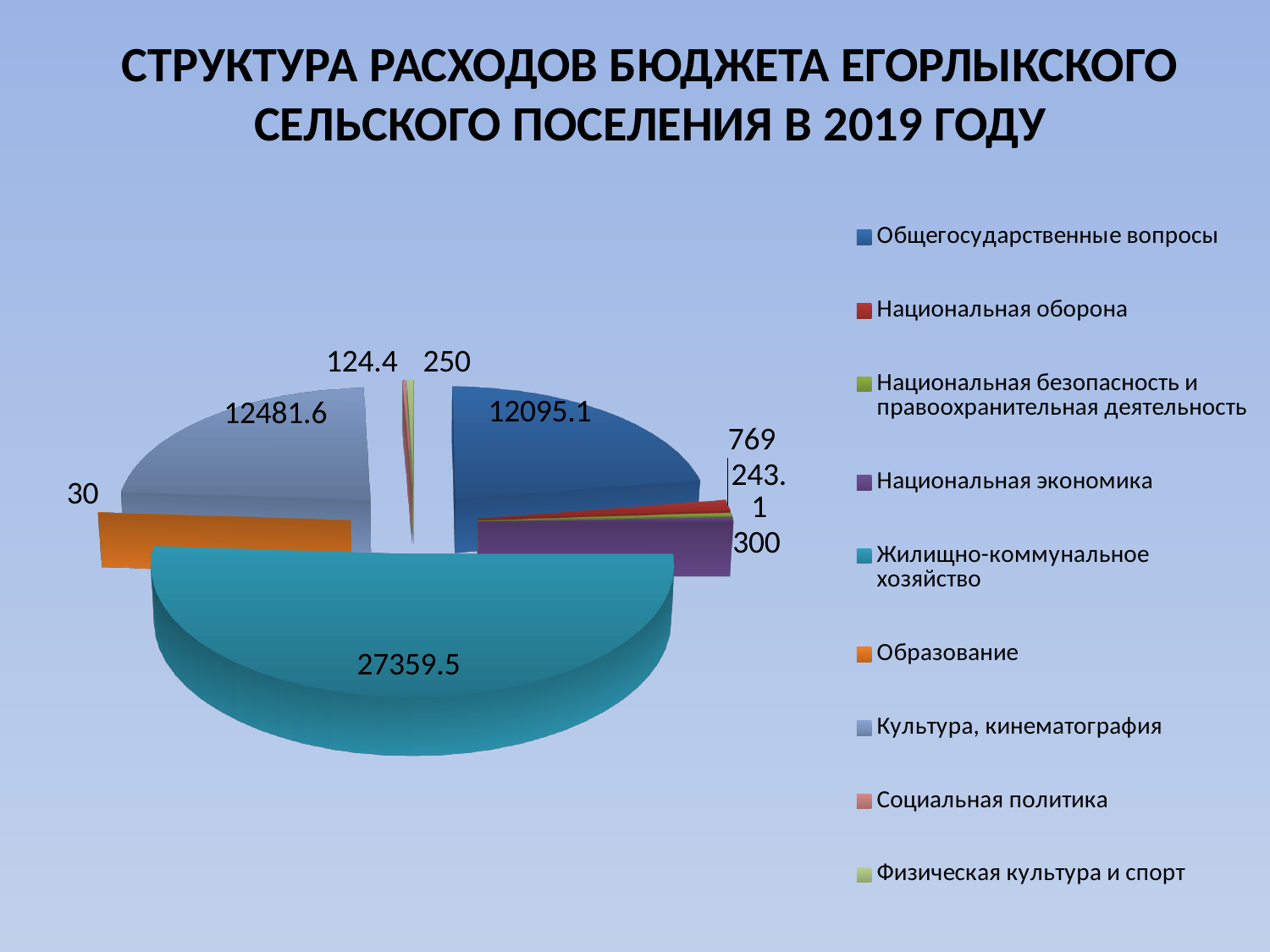
What is the value for Жилищно-коммунальное хозяйство? 27359.5 Which category has the largest slice of the pie? Жилищно-коммунальное хозяйство What is the difference between the values for Культура, кинематография and Общегосударственные вопросы? 386.5 Which is larger, the value for Национальная экономика or the value for Национальная оборона? Национальная оборона What is the value for Культура, кинематография? 12481.6 What is the value for Общегосударственные вопросы? 12095.1 How many categories does the legend list? 9 What is the value for Физическая культура и спорт? 250 What is the value for Образование? 30 What is the value for Национальная оборона? 769 Which category has the smallest value? Образование What kind of chart is shown on the slide? pie chart